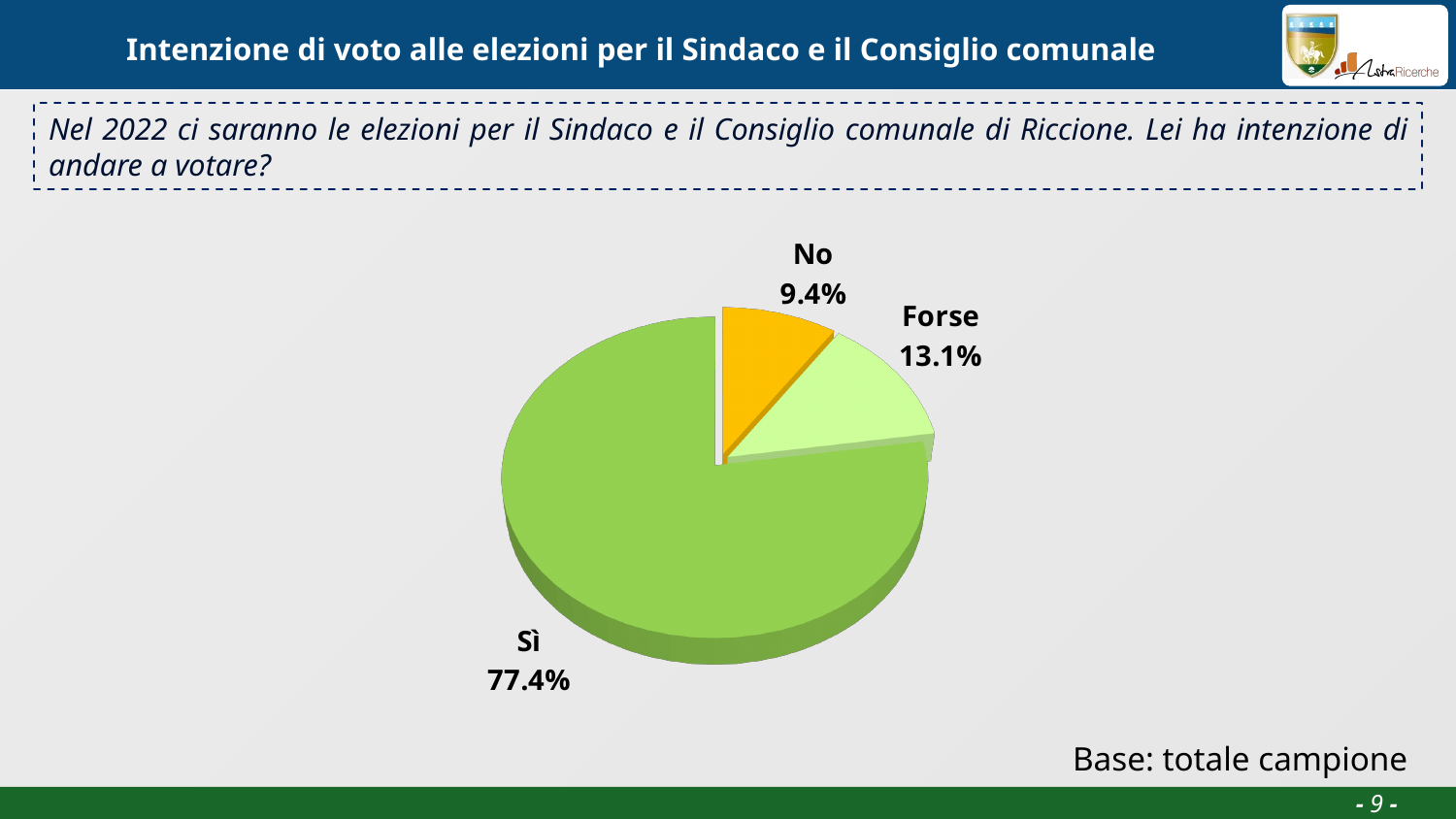
What kind of chart is shown on the slide? pie chart What is the difference in percentage points between "Sì" and "Forse"? 64.3 What percentage of respondents answered "Sì"? 77.4% What colour is the "No" slice of the pie? orange What percentage of respondents answered "Forse"? 13.1% Which response has the largest share of the pie? Sì What percentage of respondents answered "No"? 9.4% Which response has the smallest share of the pie? No What is the difference in percentage points between "Forse" and "No"? 3.7 What base is indicated for the chart data? totale campione How many slices does the pie chart have? 3 Which is larger, the share for "Forse" or the share for "No"? Forse